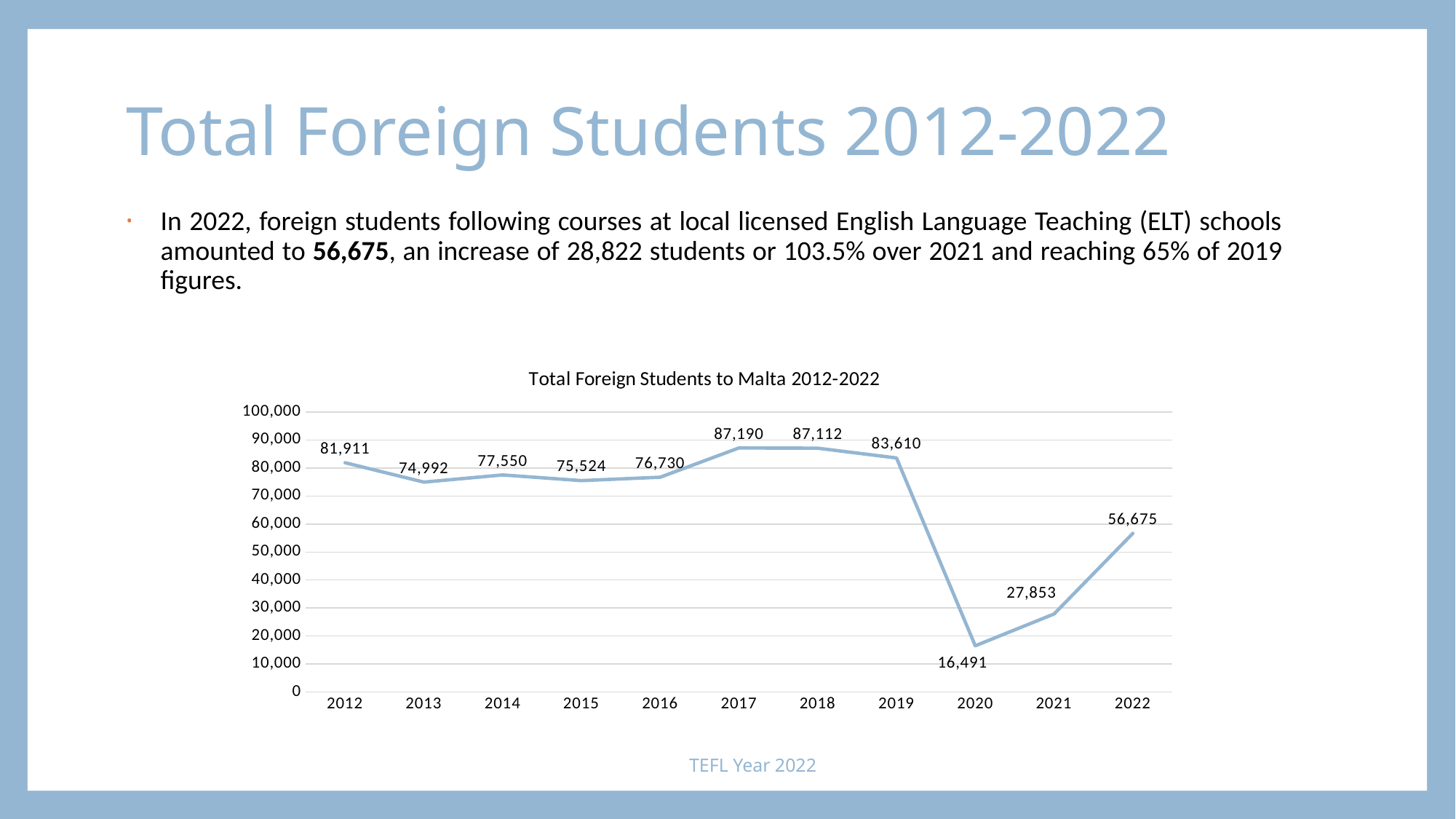
What is the value for 2012? 81,911 What is the value for 2020? 16,491 Do the values rise or fall from 2020 to 2022? rise How many years are plotted on the chart? 11 What kind of chart is shown on the slide? line chart What is the difference between the values for 2022 and 2021? 28,822 Is the value for 2019 greater or less than 80,000? greater Which year has the highest number of foreign students? 2017 Which year has the lowest number of foreign students? 2020 What is the title of the chart? Total Foreign Students to Malta 2012-2022 What is the value for 2017? 87,190 Which is larger, the value for 2014 or the value for 2015? 2014